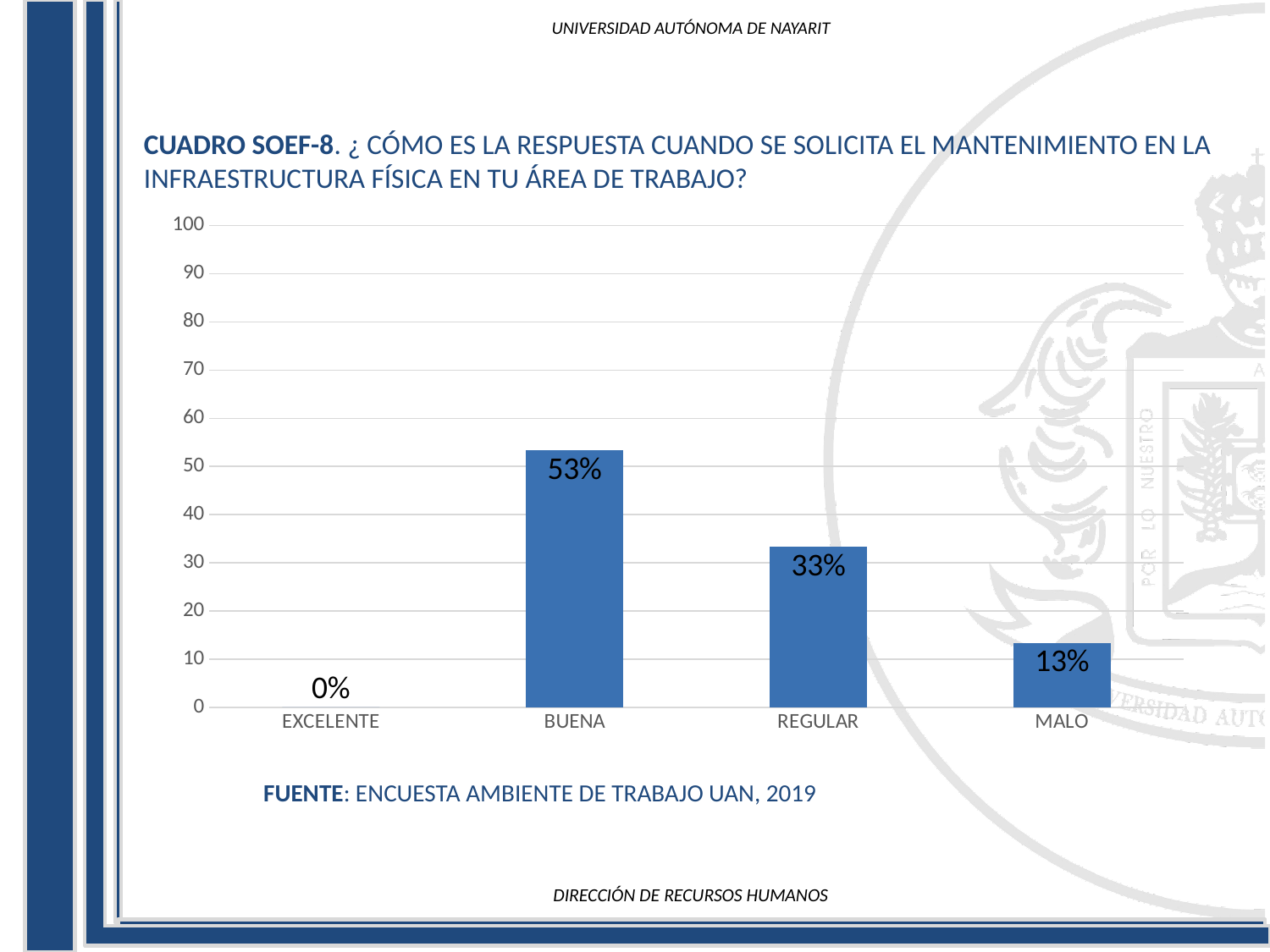
What is the value for EXCELENTE? 0% What kind of chart is shown on the slide? bar chart Which category has the lowest value? EXCELENTE How many categories are shown on the x axis? 4 What is the value for BUENA? 53% Which category has the highest value? BUENA Is the value for BUENA greater or less than 50? greater What is the value for MALO? 13% What is the value for REGULAR? 33% Which is larger, the value for REGULAR or the value for MALO? REGULAR What is the difference between the values for BUENA and REGULAR? 20% What is the difference between the values for REGULAR and MALO? 20%